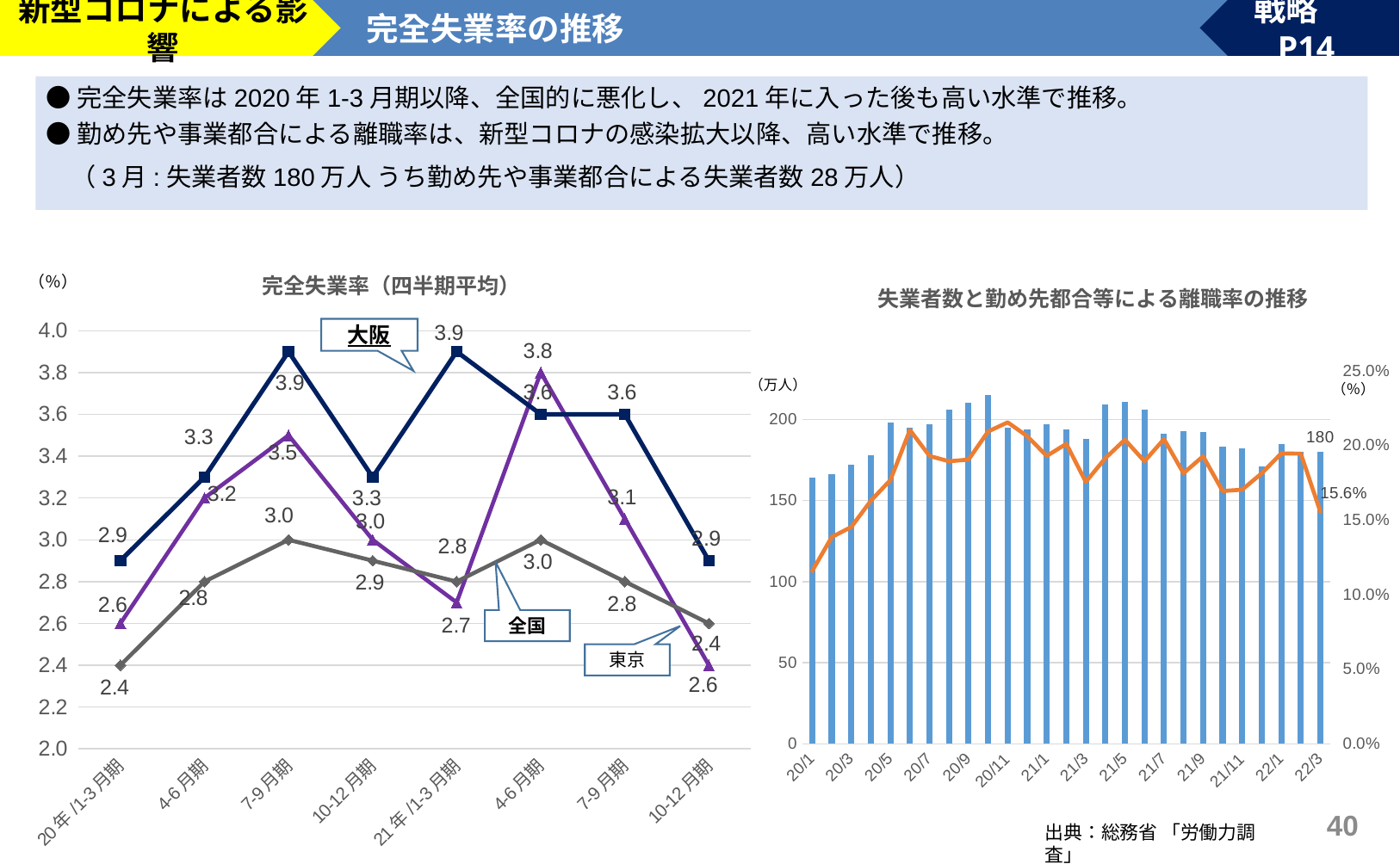
In the left chart 完全失業率（四半期平均）, which series has the highest value in the 2021 4-6月期? 東京 In the right chart 失業者数と勤め先都合等による離職率の推移, what is the labelled value of the line at 22/3? 15.6% What kind of chart is the left chart 完全失業率（四半期平均）? Line chart How many series are plotted in the left chart 完全失業率（四半期平均）? 3 In the right chart 失業者数と勤め先都合等による離職率の推移, what is the labelled value of the bar for 22/3? 180 How many quarterly periods are shown on the x axis of the left chart 完全失業率（四半期平均）? 8 In the right chart 失業者数と勤め先都合等による離職率の推移, is the bar for 20/1 greater or less than 200? less In the left chart 完全失業率（四半期平均）, what is the difference between 大阪 and 全国 in the 2020 7-9月期? 0.9 In the left chart 完全失業率（四半期平均）, what is the value for 大阪 in 21年/1-3月期? 3.9 In the left chart 完全失業率（四半期平均）, in which period is the 全国 value lowest? 20年/1-3月期 In the left chart 完全失業率（四半期平均）, what is the value for 東京 in the 2021 4-6月期? 3.8 In the left chart 完全失業率（四半期平均）, what is the value for 全国 in 20年/1-3月期? 2.4